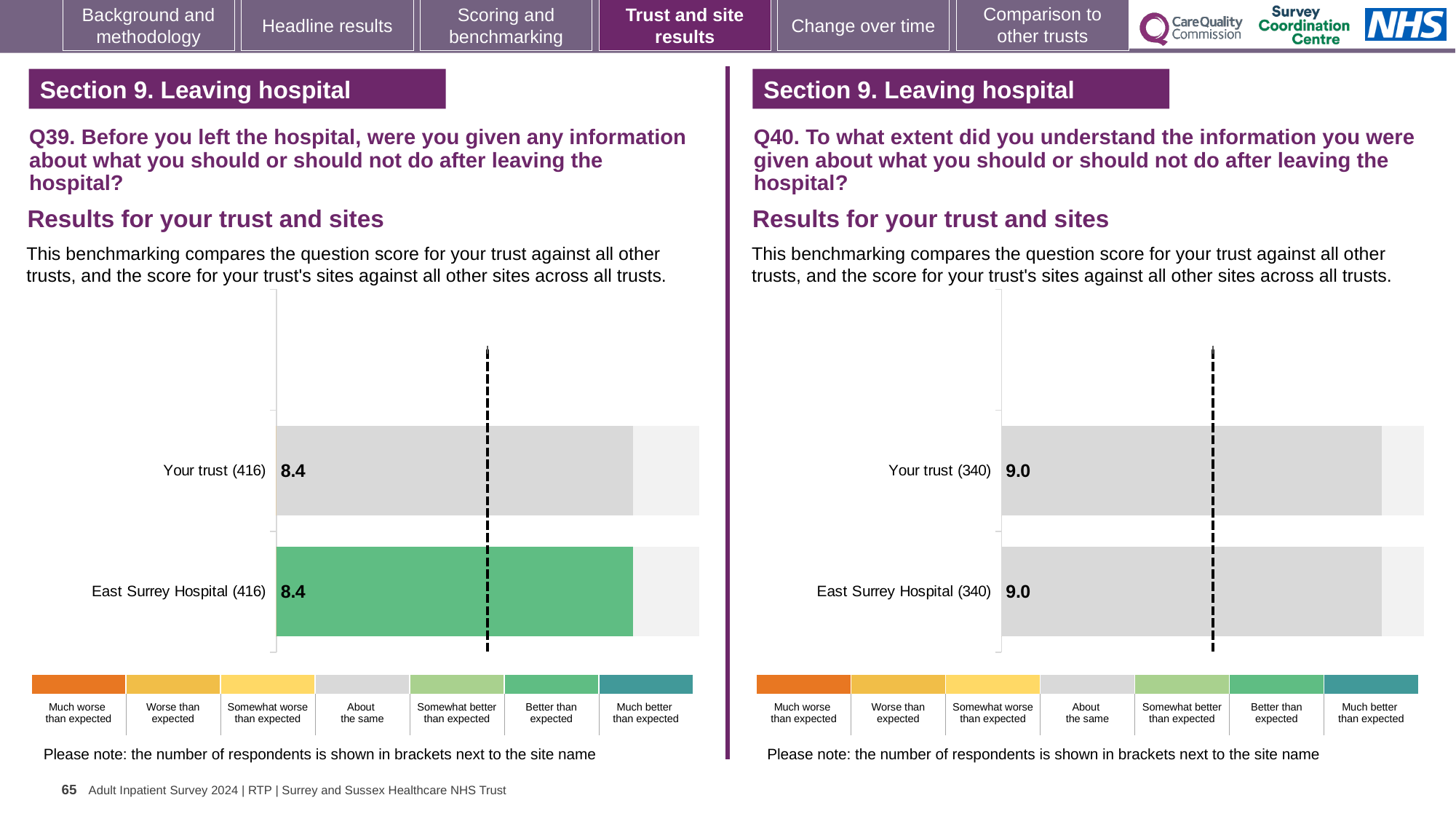
On the Q39 chart (left), how many respondents are shown in brackets for East Surrey Hospital? 416 How many bars are plotted on the Q39 chart (left)? 2 On the Q40 chart (right), what is the score for Your trust? 9.0 How many bars are plotted on the Q40 chart (right)? 2 On the Q40 chart (right), how many respondents are shown in brackets for Your trust? 340 On the Q39 chart (left), what is the score for East Surrey Hospital? 8.4 On the Q39 chart (left), what is the difference between the Your trust score and the East Surrey Hospital score? 0.0 On the Q40 chart (right), what is the difference between the Your trust score and the East Surrey Hospital score? 0.0 On the Q39 chart (left), what is the score for Your trust? 8.4 On the Q40 chart (right), what is the score for East Surrey Hospital? 9.0 What kind of chart is used on the Q39 chart (left)? Bar chart On the Q39 chart (left), which benchmark category does the green colour of the East Surrey Hospital bar correspond to in the key? Better than expected